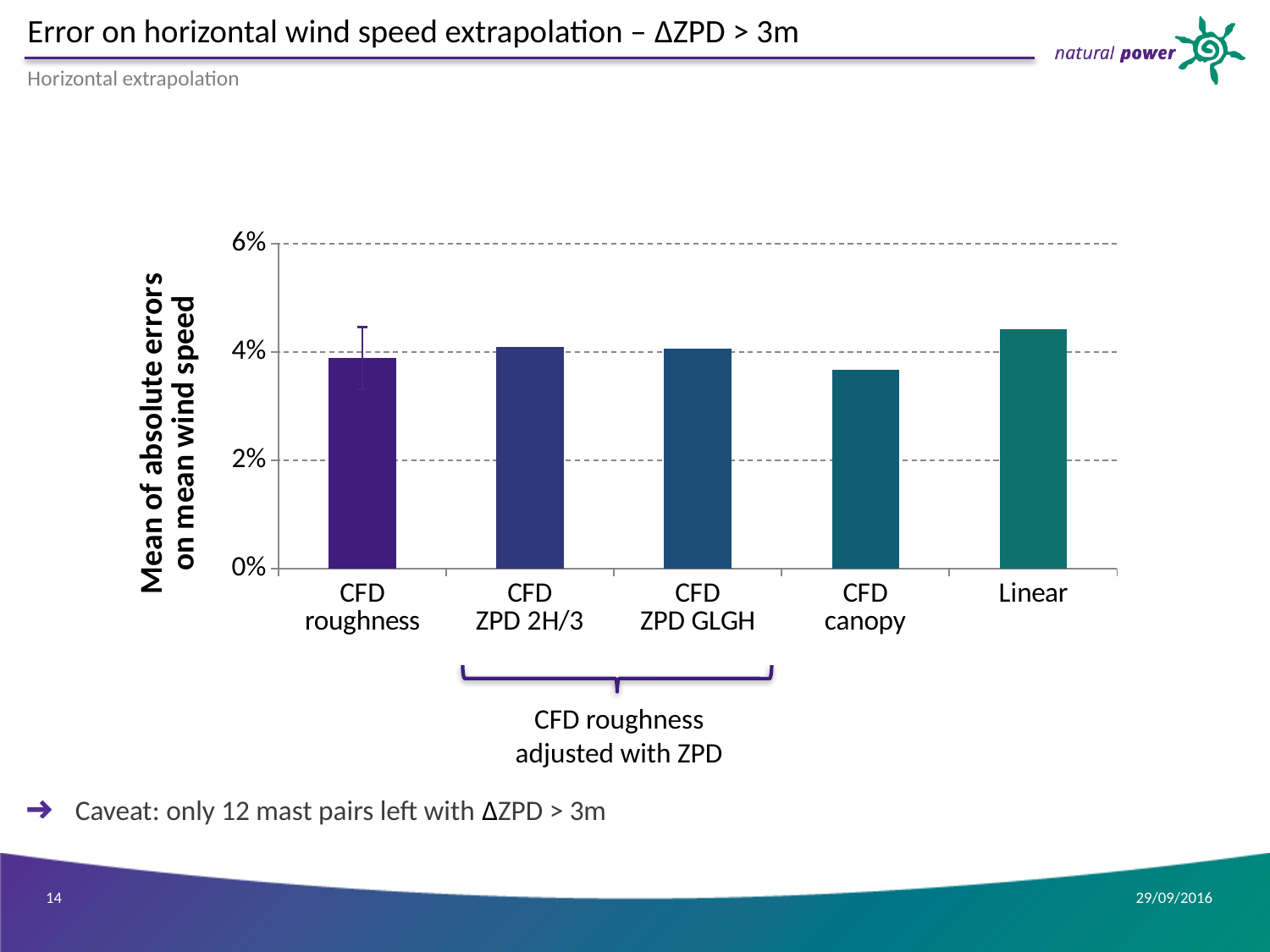
Is the value for CFD roughness greater or less than 4%? less Which category has the lowest mean of absolute errors on mean wind speed? CFD canopy Is the value for Linear greater or less than 4%? greater Is the value for CFD canopy greater or less than 2%? greater Which is larger, the value for CFD ZPD 2H/3 or the value for CFD canopy? CFD ZPD 2H/3 What is the label on the vertical axis of the chart? Mean of absolute errors on mean wind speed Which is larger, the value for Linear or the value for CFD canopy? Linear Which category has the highest mean of absolute errors on mean wind speed? Linear How many bars (categories) does the chart show? 5 What kind of chart is shown on the slide? Bar chart Which bar in the chart has an error bar drawn on it? CFD roughness